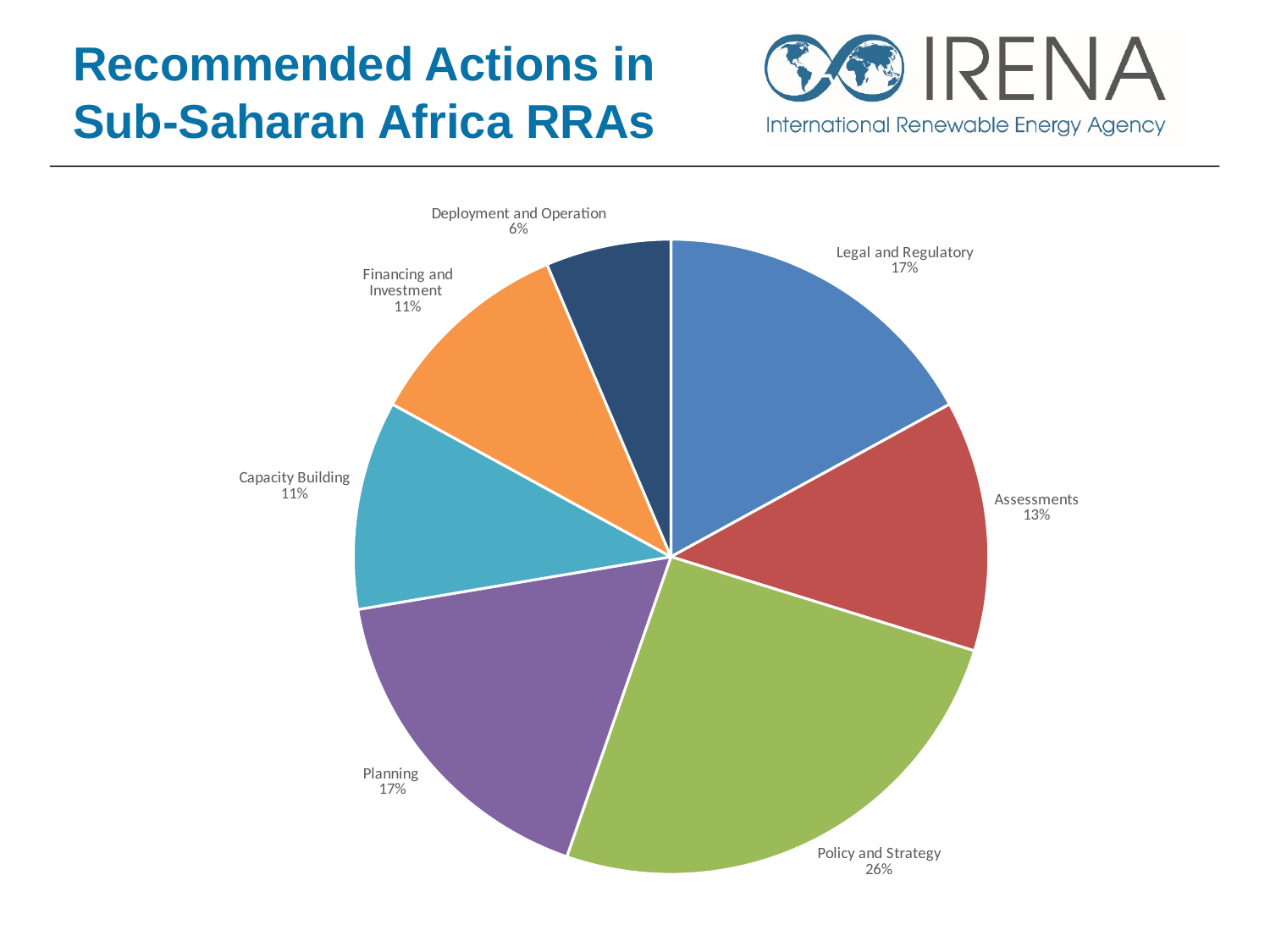
What is the difference in percentage points between Policy and Strategy and Assessments? 13 How many categories are shown in the pie chart? 7 Which category has the smallest slice of the pie? Deployment and Operation Which is larger, the slice for Legal and Regulatory or the slice for Capacity Building? Legal and Regulatory What is the value shown for Financing and Investment? 11% What share of the pie does Policy and Strategy represent? 26% Which category has the largest slice of the pie? Policy and Strategy What is the value shown for Assessments? 13% What colour is the Policy and Strategy slice? green What is the difference in percentage points between Planning and Deployment and Operation? 11 What kind of chart is shown on the slide? pie chart What is the value shown for Deployment and Operation? 6%